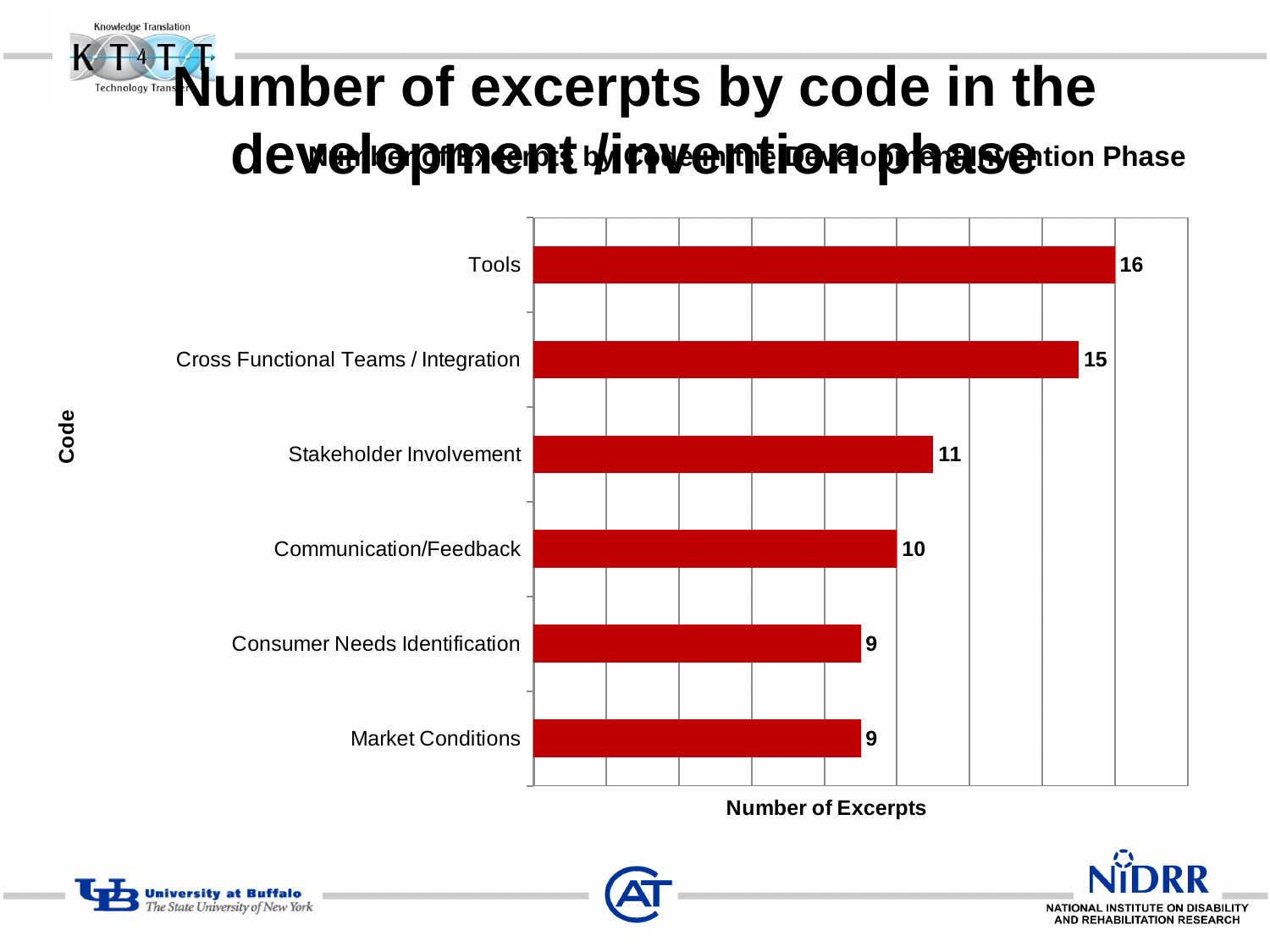
What is the number of excerpts for Cross Functional Teams / Integration? 15 What is the difference in number of excerpts between Tools and Stakeholder Involvement? 5 What kind of chart is shown on the slide? Bar chart What is the difference in number of excerpts between Cross Functional Teams / Integration and Communication/Feedback? 5 What is the number of excerpts for Stakeholder Involvement? 11 Which code has the highest number of excerpts? Tools What is the label of the vertical axis? Code What is the label of the horizontal axis? Number of Excerpts How many codes are shown on the chart? 6 Which has more excerpts, Stakeholder Involvement or Consumer Needs Identification? Stakeholder Involvement What is the number of excerpts for Communication/Feedback? 10 What is the number of excerpts for Tools? 16